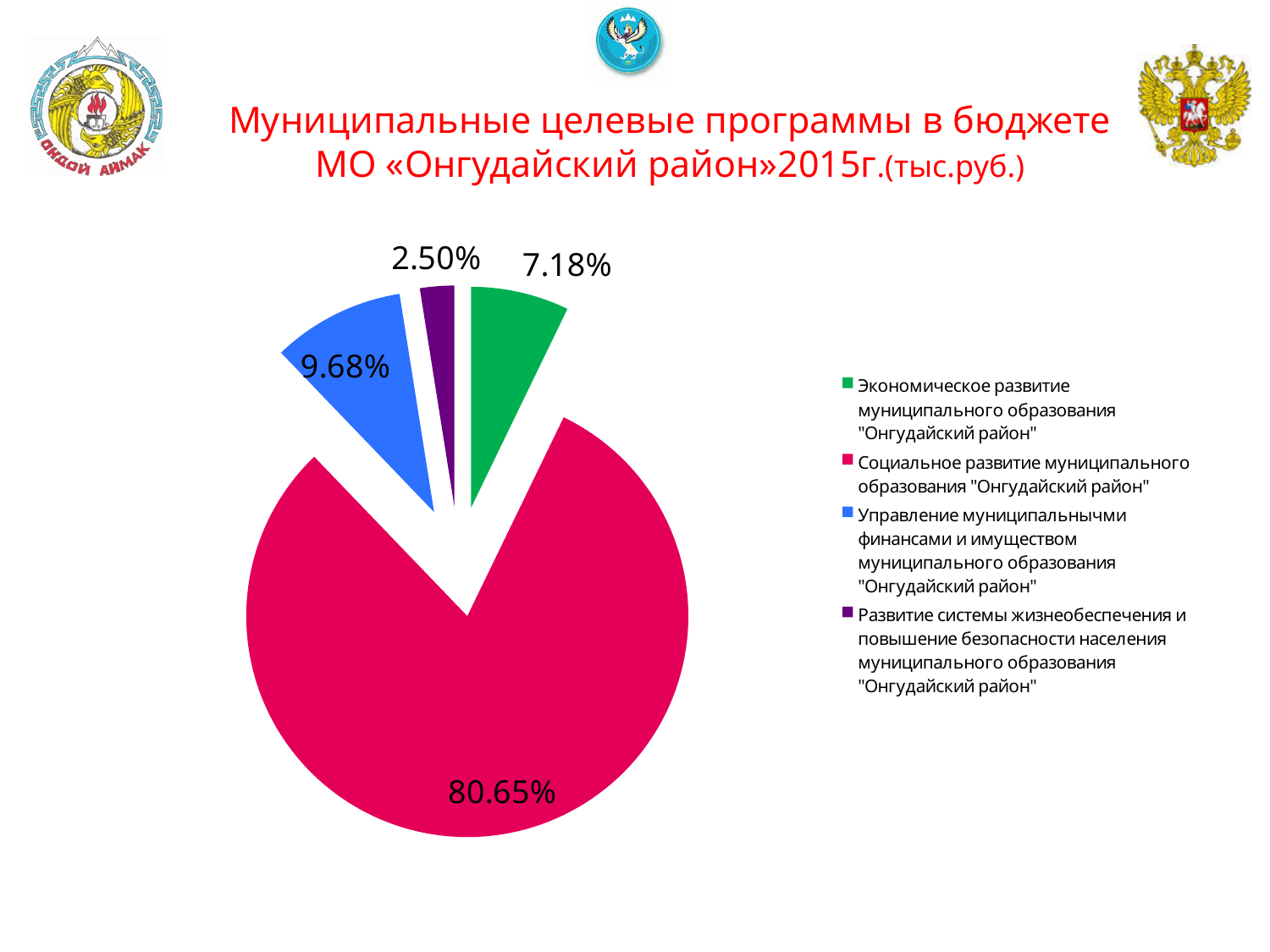
Which is larger: the "Экономическое развитие" slice or the "Управление муниципальнычми финансами и имуществом" slice? Управление муниципальнычми финансами и имуществом муниципального образования "Онгудайский район" What is the difference in percentage points between the "Управление муниципальнычми финансами и имуществом" slice and the "Экономическое развитие" slice? 2.50 What share of the pie does "Развитие системы жизнеобеспечения и повышение безопасности населения муниципального образования "Онгудайский район"" have? 2.50% What share of the pie does "Социальное развитие муниципального образования "Онгудайский район"" have? 80.65% What share of the pie does "Экономическое развитие муниципального образования "Онгудайский район"" have? 7.18% Which category has the largest slice of the pie? Социальное развитие муниципального образования "Онгудайский район" What share of the pie does "Управление муниципальнычми финансами и имуществом муниципального образования "Онгудайский район"" have? 9.68% How many slices does the pie chart have? 4 What is the title of the slide containing the chart? Муниципальные целевые программы в бюджете МО «Онгудайский район»2015г.(тыс.руб.) What colour is the slice for "Социальное развитие муниципального образования "Онгудайский район""? red What kind of chart is shown on the slide? pie chart Which category has the smallest slice of the pie? Развитие системы жизнеобеспечения и повышение безопасности населения муниципального образования "Онгудайский район"